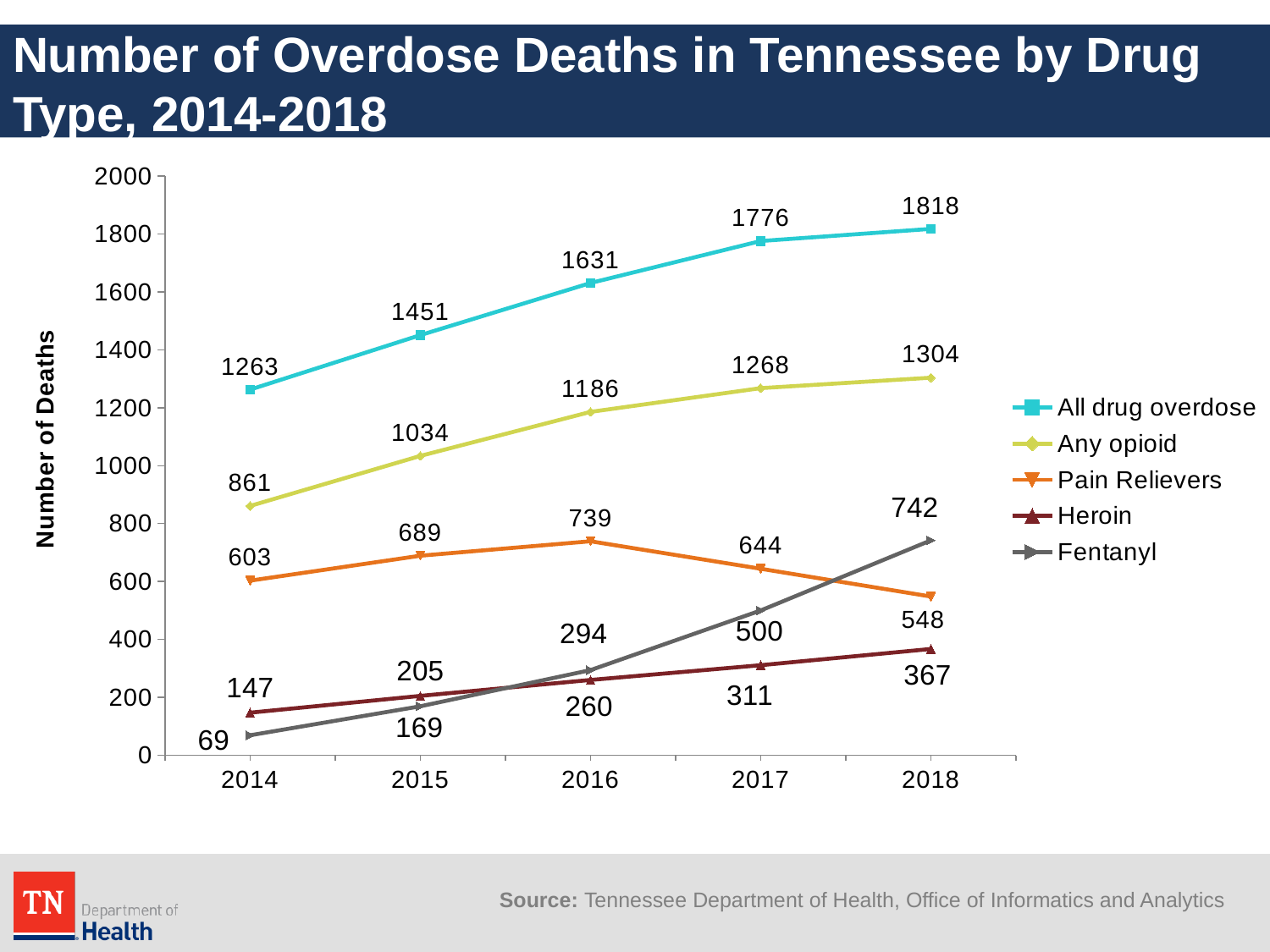
What was the number of all drug overdose deaths in Tennessee in 2018? 1818 What was the number of pain reliever overdose deaths in 2016? 739 In which year were heroin overdose deaths lowest? 2014 What is the difference between fentanyl deaths and heroin deaths in 2018? 375 By how much did all drug overdose deaths increase from 2014 to 2018? 555 How many series does the legend list? 5 How many fentanyl overdose deaths were there in 2014? 69 What kind of chart is shown on the slide? Line chart In 2017, which had more overdose deaths: pain relievers or fentanyl? Pain Relievers In which year did pain reliever overdose deaths reach their highest value? 2016 How many years are plotted on the x axis? 5 Do fentanyl overdose deaths rise or fall from 2014 to 2018? Rise